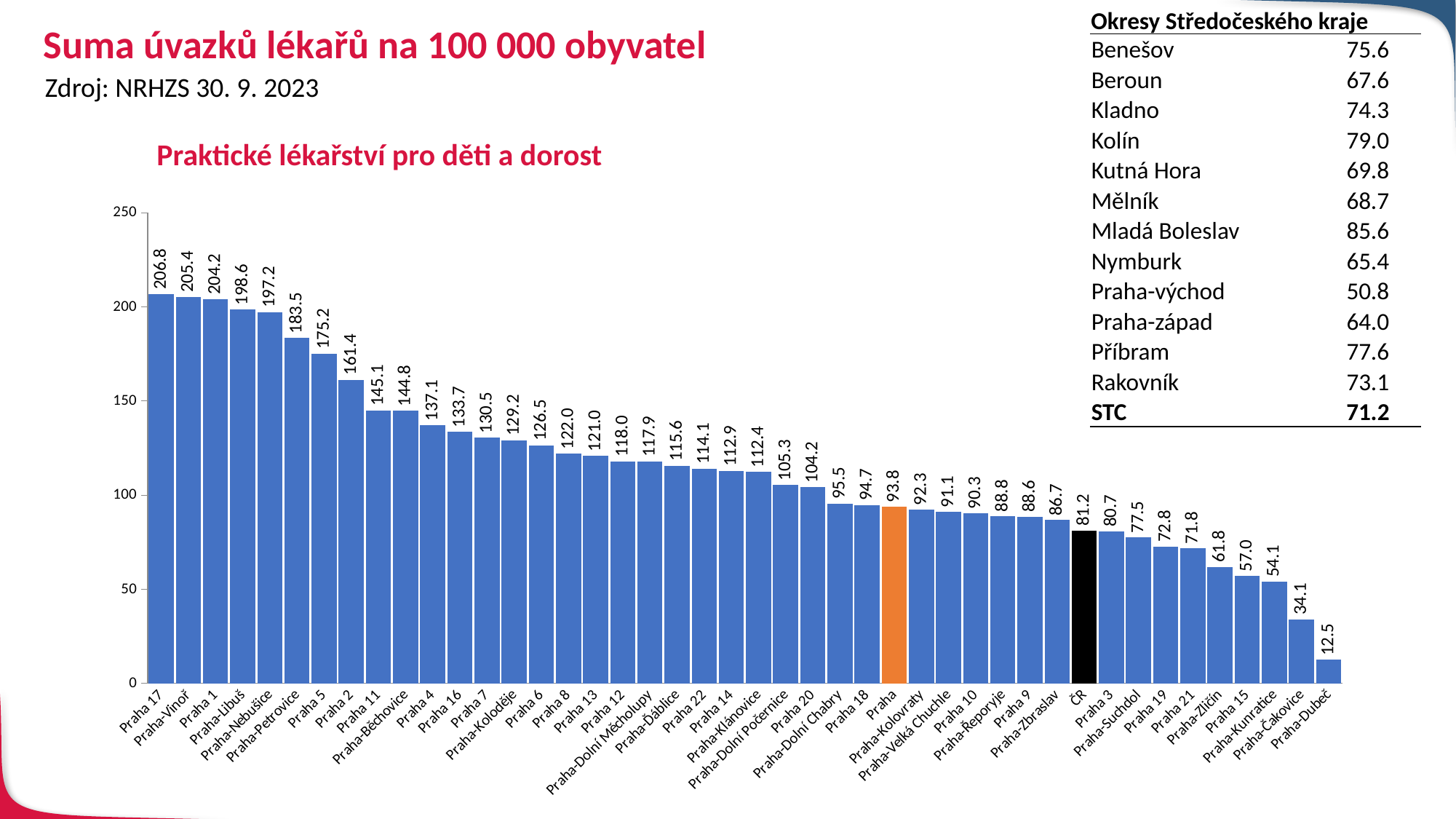
What kind of chart is shown? bar chart Which category has the highest value? Praha 17 Do the values rise or fall from left to right along the x axis? fall What is the difference between the values for Praha and ČR? 12.6 Which is larger, the value for Praha 5 or the value for Praha 2? Praha 5 Which category has the lowest value? Praha-Dubeč What is the value for Praha-Dubeč? 12.5 What is the value for Praha 17? 206.8 How many bars are plotted in the chart? 44 What is the value for ČR? 81.2 Is the value for Praha-Petrovice greater or less than 150? greater What is the value for Praha-Klánovice? 112.4